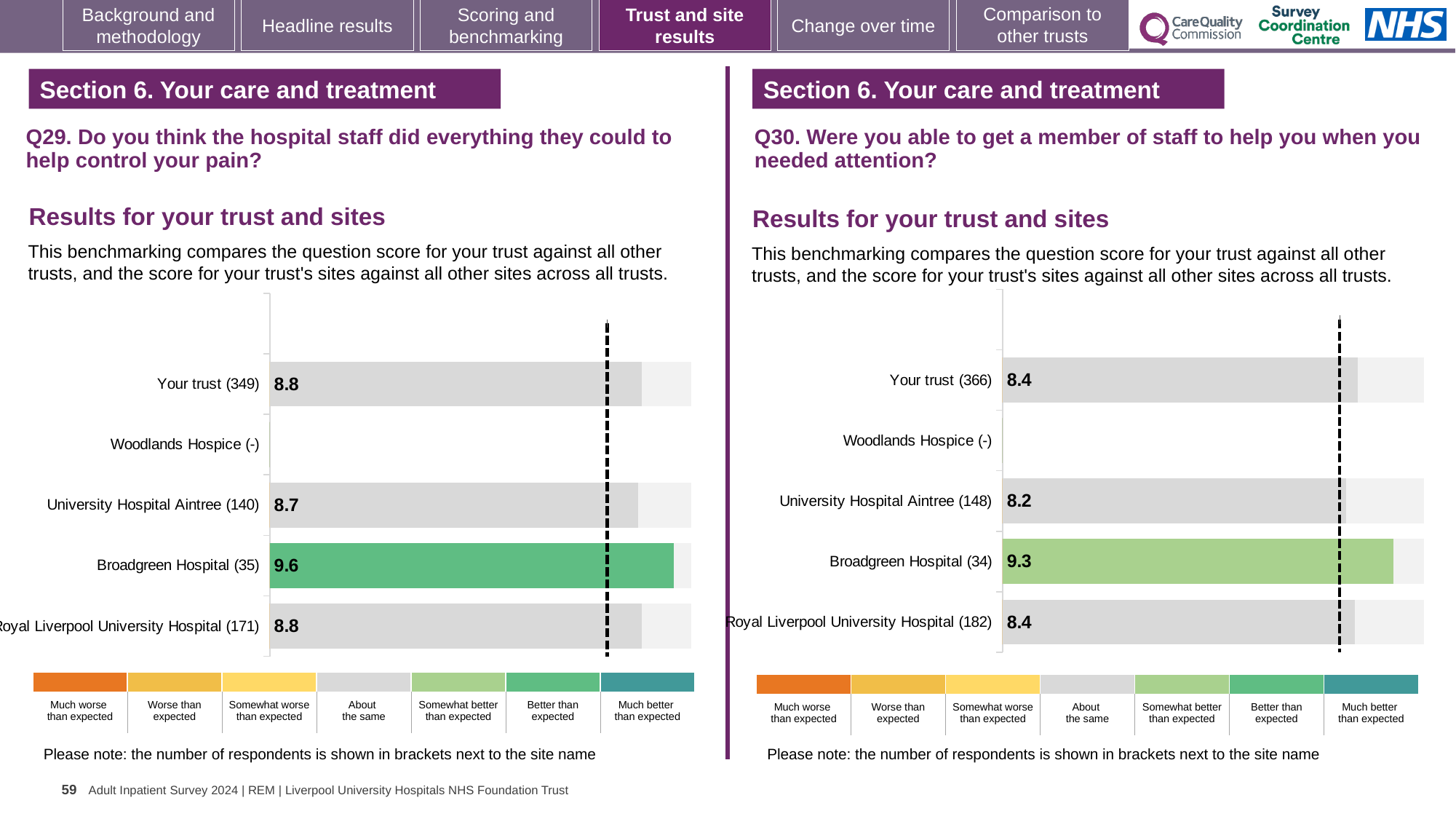
In the Q29 chart on the left, what is the difference between the scores for Broadgreen Hospital and University Hospital Aintree? 0.9 In the Q30 chart on the right, which has the larger score, Broadgreen Hospital or University Hospital Aintree? Broadgreen Hospital What kind of chart is the Q30 chart on the right? Bar chart In the Q30 chart on the right, what is the score for Your trust? 8.4 How many site or trust labels are listed on the vertical axis of the Q29 chart on the left? 5 In the Q30 chart on the right, what is the score for Royal Liverpool University Hospital? 8.4 In the Q30 chart on the right, what is the difference between the scores for Broadgreen Hospital and Your trust? 0.9 In the Q29 chart on the left, which site has the highest score? Broadgreen Hospital In the Q30 chart on the right, which site has the lowest plotted score? University Hospital Aintree In the Q29 chart on the left, what is the score for Broadgreen Hospital? 9.6 In the Q29 chart on the left, which benchmark category does the colour of the Broadgreen Hospital bar correspond to in the legend? Better than expected In the Q29 chart on the left, what is the score for University Hospital Aintree? 8.7